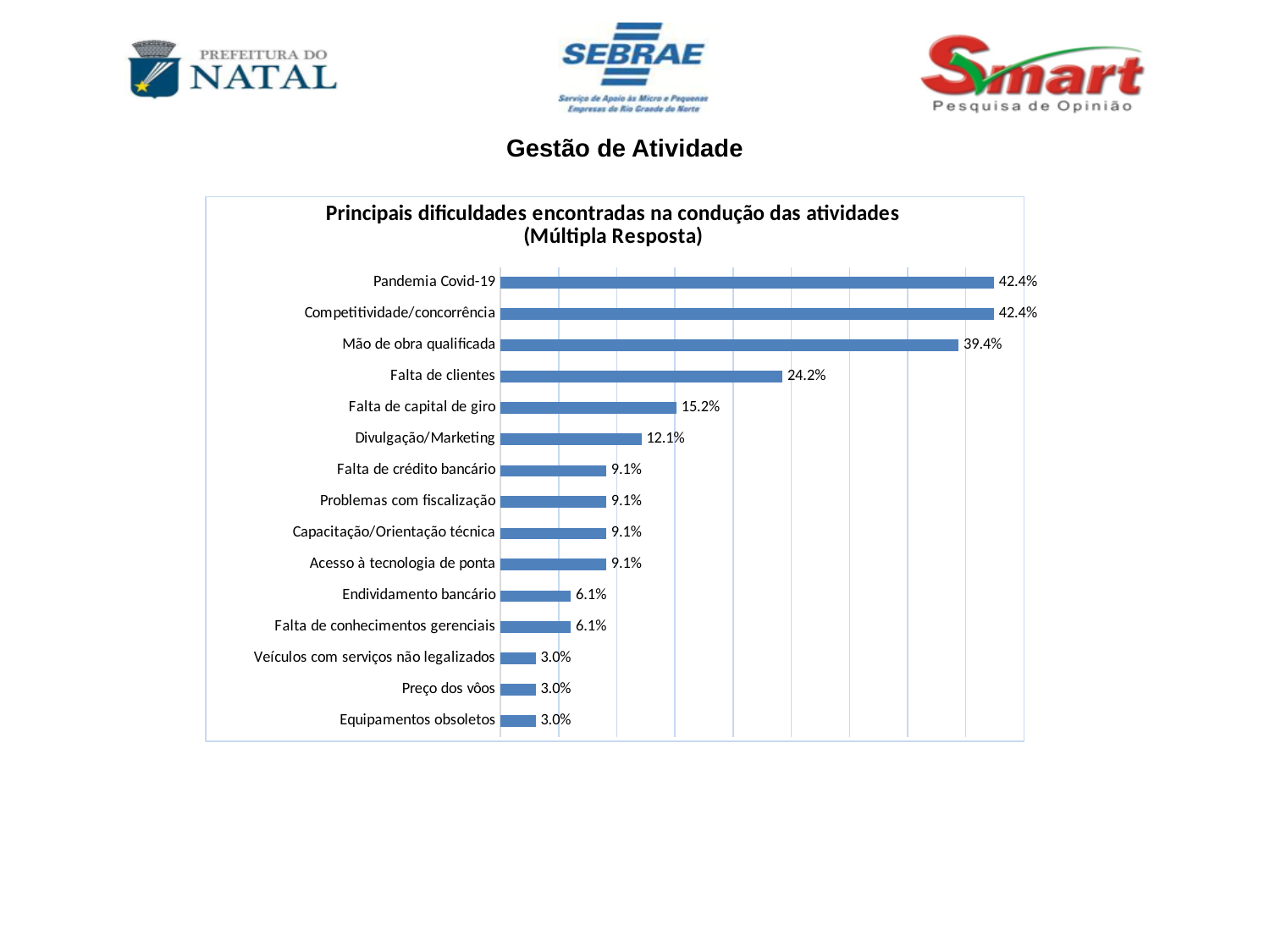
What kind of chart is shown on the slide? Bar chart What is the value for Falta de clientes? 24.2% What is the value for Mão de obra qualificada? 39.4% What is the value for Divulgação/Marketing? 12.1% What is the highest value shown in the chart? 42.4% What is the difference between the values for Pandemia Covid-19 and Mão de obra qualificada? 3.0% What is the title of the chart? Principais dificuldades encontradas na condução das atividades (Múltipla Resposta) What is the lowest value shown in the chart? 3.0% What is the value for Endividamento bancário? 6.1% How many categories are shown in the chart? 15 Which is larger, the value for Falta de capital de giro or the value for Divulgação/Marketing? Falta de capital de giro What is the difference between the values for Falta de clientes and Falta de capital de giro? 9.0%